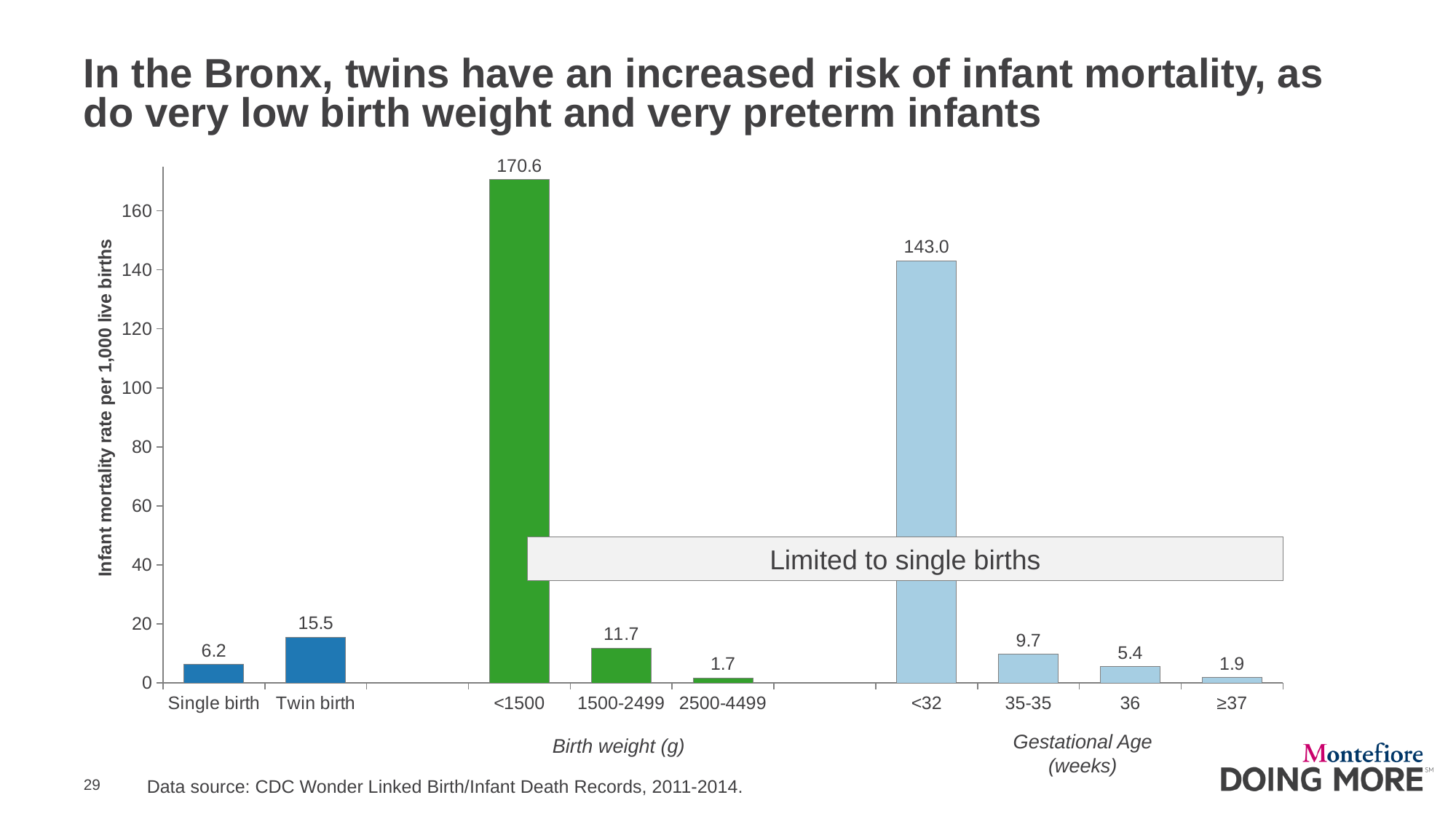
What type of chart is shown on the slide? Bar chart What is the infant mortality rate for infants with gestational age ≥37 weeks? 1.9 What is the difference in infant mortality rate between the <1500 g birth weight group and the <32 weeks gestational age group? 27.6 Which has a higher infant mortality rate: the 1500-2499 g birth weight group or the 35-35 weeks gestational age group? 1500-2499 What is the infant mortality rate for infants with birth weight <1500 g? 170.6 What is the label on the vertical axis of the chart? Infant mortality rate per 1,000 live births How many bars are plotted on the chart? 9 What is the infant mortality rate per 1,000 live births for twin births? 15.5 What is the infant mortality rate for infants with gestational age <32 weeks? 143.0 What is the difference in infant mortality rate between twin births and single births? 9.3 Which category has the highest infant mortality rate on the chart? <1500 Which category has the lowest infant mortality rate on the chart? 2500-4499